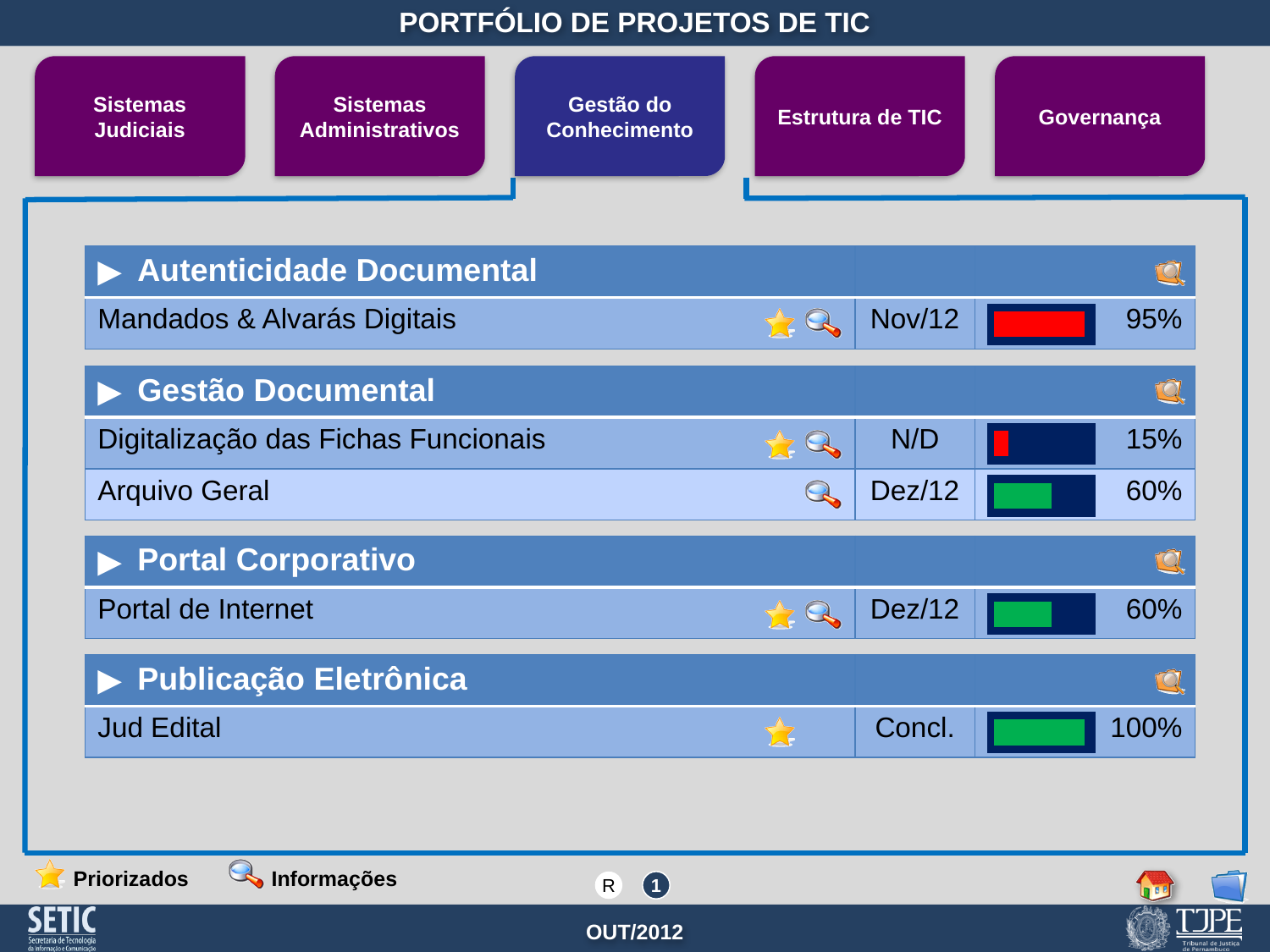
Which project has the highest completion percentage? Jud Edital How many projects have a progress bar shown on the slide? 5 What completion percentage is shown for Arquivo Geral? 60% Which project has the lowest completion percentage? Digitalização das Fichas Funcionais What deadline is shown for Mandados & Alvarás Digitais? Nov/12 What colour is the progress bar for Jud Edital? Green Which has a higher completion percentage, Portal de Internet or Digitalização das Fichas Funcionais? Portal de Internet What completion percentage is shown for Digitalização das Fichas Funcionais? 15% What is the difference in completion percentage between Mandados & Alvarás Digitais and Arquivo Geral? 35% What colour is the progress bar for Digitalização das Fichas Funcionais? Red What completion percentage is shown for Jud Edital? 100% What completion percentage is shown for Mandados & Alvarás Digitais? 95%